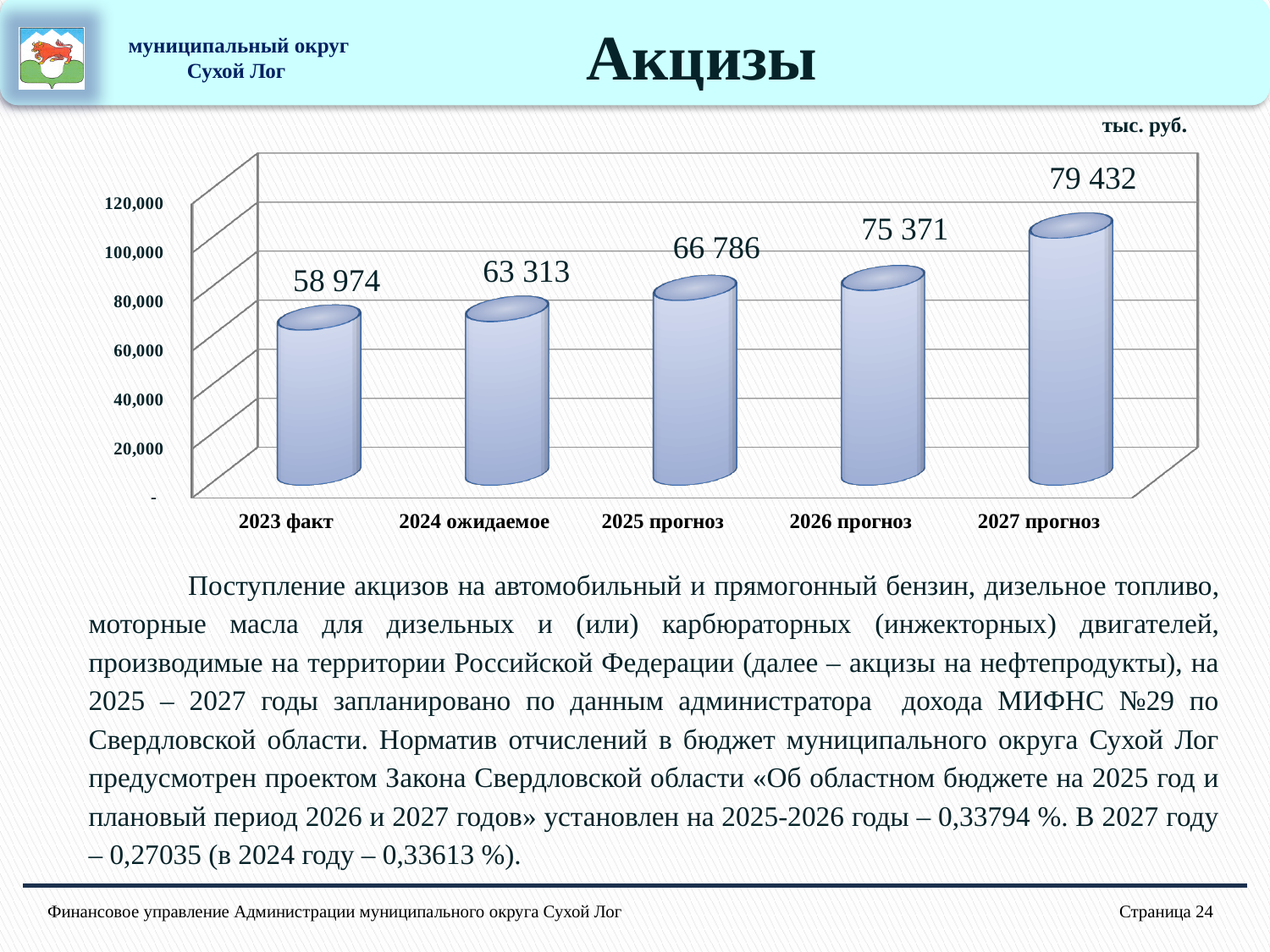
Do the values rise or fall from 2023 факт to 2027 прогноз? Rise What is the value for 2025 прогноз? 66 786 What is the difference between the values for 2027 прогноз and 2023 факт? 20 458 What is the difference between the values for 2026 прогноз and 2025 прогноз? 8 585 Which is larger, the value for 2024 ожидаемое or the value for 2026 прогноз? 2026 прогноз What is the value for 2027 прогноз? 79 432 What kind of chart is shown on the slide? Bar chart What is the value for 2023 факт? 58 974 What is the value for 2024 ожидаемое? 63 313 How many categories are shown on the x axis? 5 Which category has the highest value? 2027 прогноз Which category has the lowest value? 2023 факт